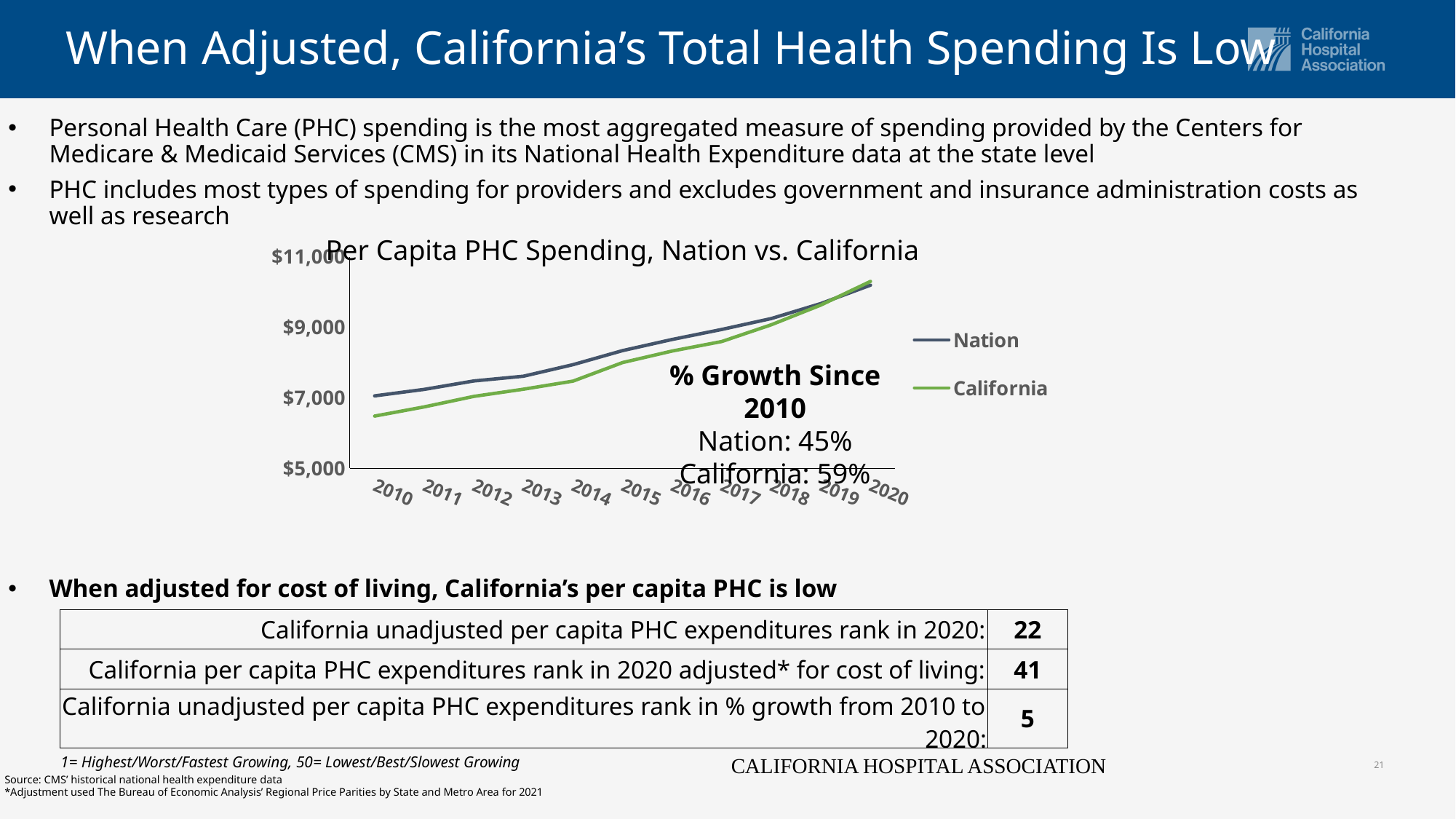
In 2015, which series has the higher per capita PHC spending, Nation or California? Nation Which series is drawn in green in the chart? California According to the annotation on the chart, what is California's % growth since 2010? 59% What is the title of the chart? Per Capita PHC Spending, Nation vs. California According to the annotation on the chart, what is the Nation's % growth since 2010? 45% In 2010, which series has the higher per capita PHC spending, Nation or California? Nation How many series does the chart's legend list? 2 What kind of chart is shown on the slide? Line chart How many years are shown along the x axis of the chart? 11 Do the per capita PHC spending values for the Nation rise or fall from 2010 to 2020? Rise Is the value for California in 2010 greater or less than $7,000? less Is the value for Nation in 2020 greater or less than $9,000? greater